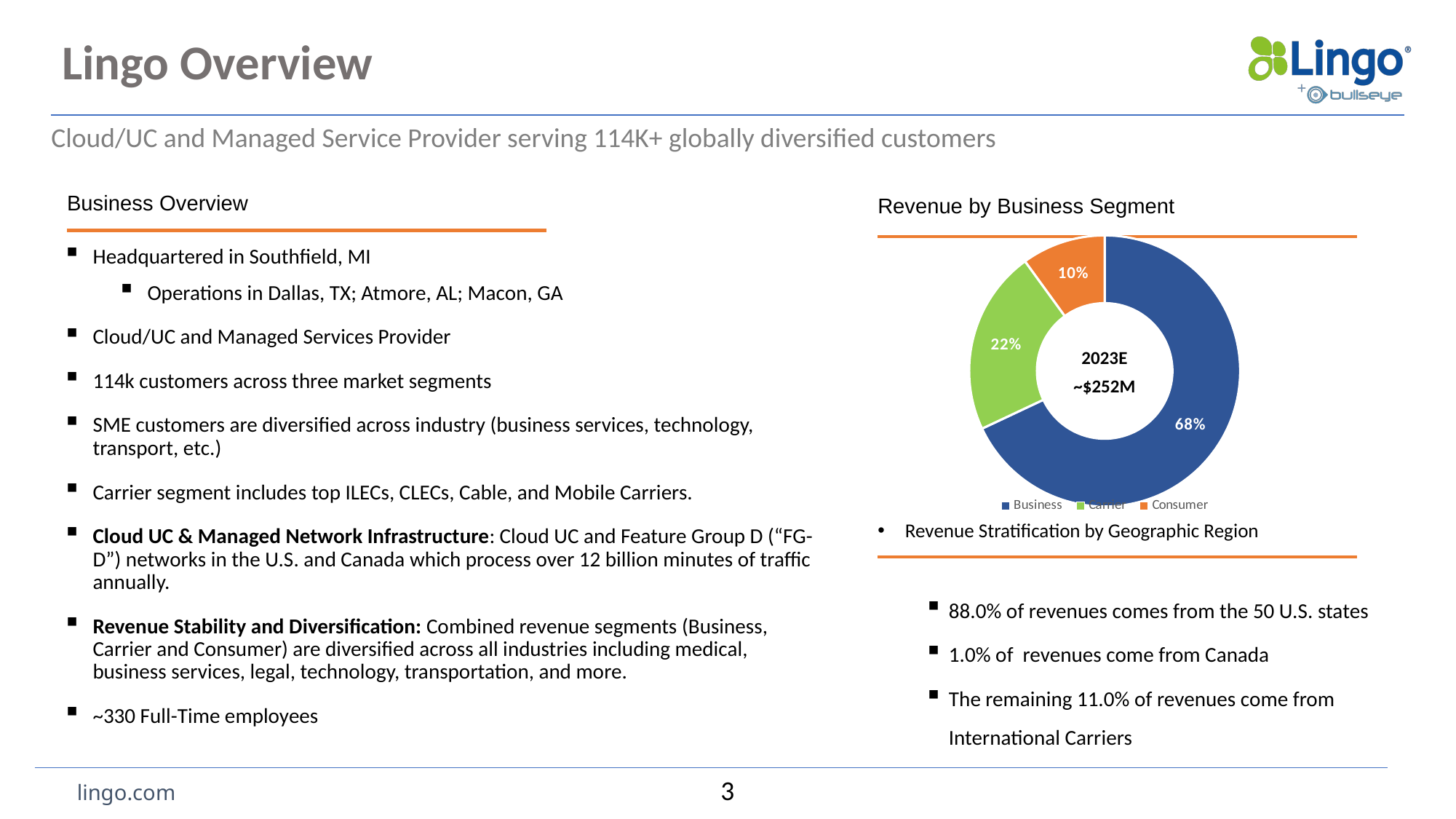
How many percentage points larger is the Carrier share than the Consumer share? 12 What colour represents the Carrier segment in the chart? Green How many segments are shown in the Revenue by Business Segment chart? 3 Which business segment has the largest share of revenue? Business What kind of chart is used to show Revenue by Business Segment? Pie chart (donut) Which segment has a larger share of revenue, Carrier or Consumer? Carrier How many percentage points larger is the Business share than the Carrier share? 46 What year and revenue figure are shown in the centre of the donut chart? 2023E ~$252M What share of revenue does the Consumer segment account for? 10% What share of revenue does the Carrier segment account for? 22% Which business segment has the smallest share of revenue? Consumer What share of revenue does the Business segment account for in the Revenue by Business Segment chart? 68%